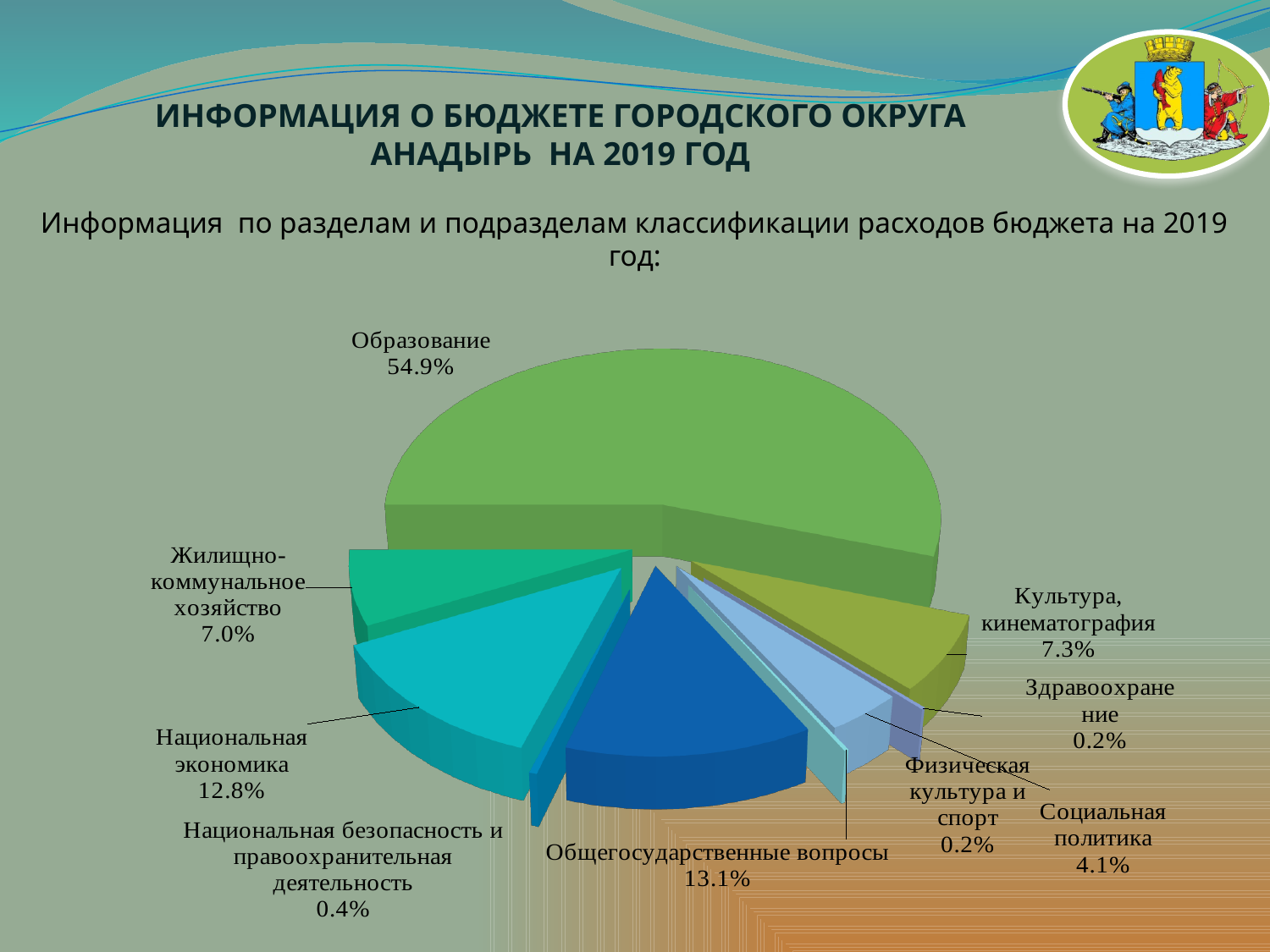
What kind of chart is shown on the slide? Pie chart What is the value shown for Жилищно-коммунальное хозяйство? 7.0% Which category has the largest share of the pie? Образование How many categories are shown in the pie chart? 9 Which is larger: Культура, кинематография or Жилищно-коммунальное хозяйство? Культура, кинематография What share of the budget expenditure goes to Образование? 54.9% What is the value shown for Здравоохранение? 0.2% What is the value shown for Национальная безопасность и правоохранительная деятельность? 0.4% What is the difference in percentage points between Общегосударственные вопросы and Национальная экономика? 0.3 What is the value shown for Национальная экономика? 12.8% What is the value shown for Общегосударственные вопросы? 13.1% What is the value shown for Социальная политика? 4.1%